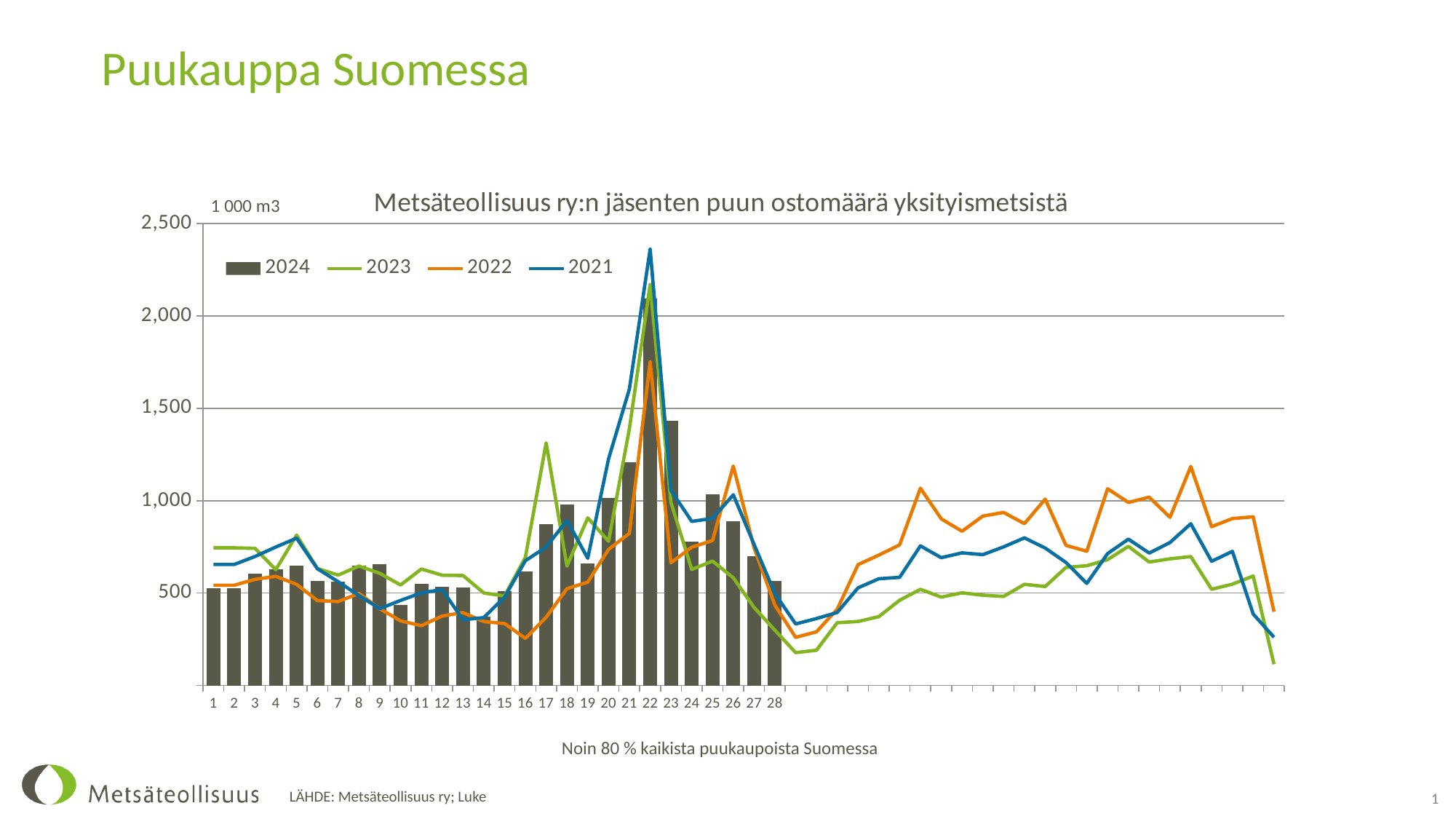
Is the 2021 line's peak at week 22 greater or less than 2,000? greater In which week is the 2024 bar highest? 22 Do the 2024 bars rise or fall from week 22 to week 28? Fall Is the 2024 bar for week 22 greater or less than 1,500? greater Is the 2024 bar for week 14 greater or less than 500? less What unit is shown above the vertical axis? 1 000 m3 Which is larger, the 2024 bar for week 17 or for week 18? Week 18 What kind of chart is shown on the slide? A combined bar and line chart How many series does the legend list? 4 How many weeks have a 2024 bar plotted? 28 Which series reaches the highest value at week 22? 2021